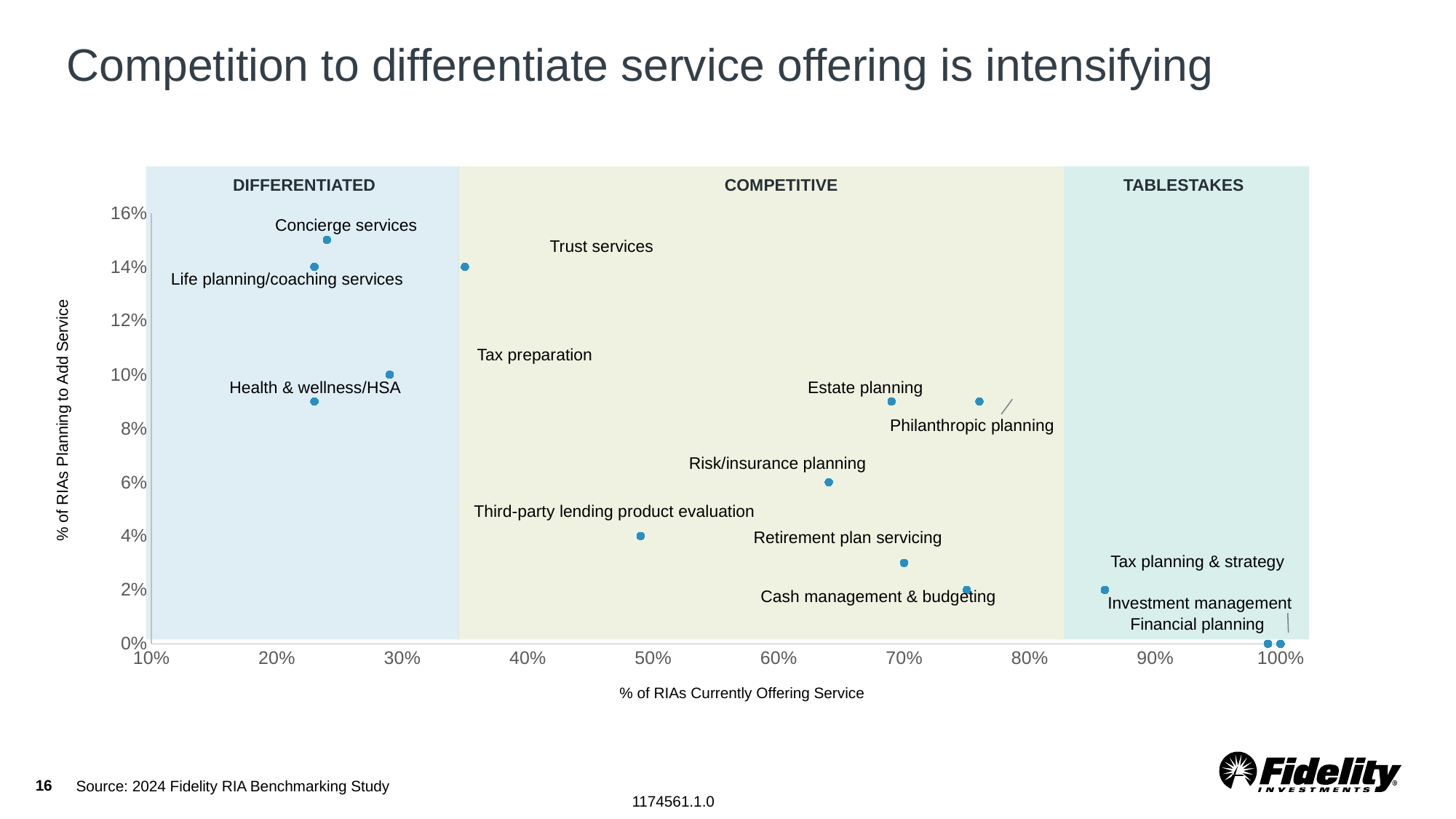
Is the % of RIAs planning to add Concierge services greater or less than 14%? greater How many services are plotted as points on the chart? 14 What is the % of RIAs planning to add Third-party lending product evaluation? 4% What kind of chart is shown on the slide? Scatter chart What is the % of RIAs planning to add Risk/insurance planning? 6% What are the three zones labelled across the top of the chart? Differentiated, Competitive, Tablestakes Which has a higher % of RIAs planning to add the service, Trust services or Tax preparation? Trust services What is the % of RIAs planning to add Trust services? 14% Is the % of RIAs planning to add Health & wellness/HSA greater or less than 10%? less Which service has the highest % of RIAs planning to add the service? Concierge services Which service has the highest % of RIAs currently offering the service? Financial planning What is the % of RIAs planning to add Tax preparation? 10%